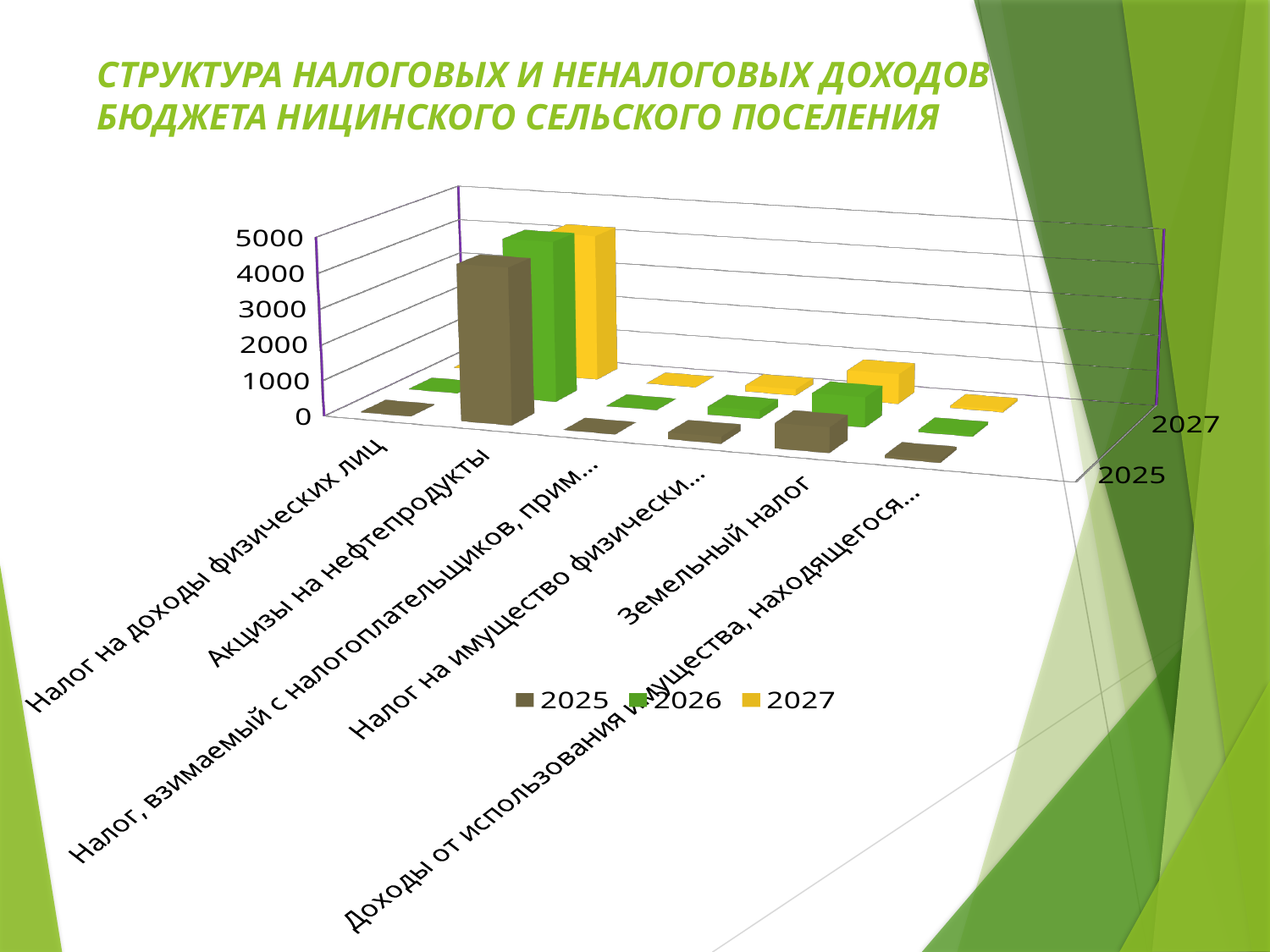
Which years are listed in the legend? 2025, 2026, 2027 Is the 2025 value for Налог на доходы физических лиц greater or less than 1000? less For 2027, which is larger: Акцизы на нефтепродукты or Налог на доходы физических лиц? Акцизы на нефтепродукты What kind of chart is shown on the slide? bar chart Is the 2026 value for Акцизы на нефтепродукты greater or less than 3000? greater For 2025, which is larger: Акцизы на нефтепродукты or Земельный налог? Акцизы на нефтепродукты Which category has the highest bars in the chart? Акцизы на нефтепродукты Is the 2025 value for Акцизы на нефтепродукты greater or less than 2000? greater What is the highest value shown on the vertical axis of the chart? 5000 How many series does the legend list? 3 How many categories are shown on the x axis of the chart? 6